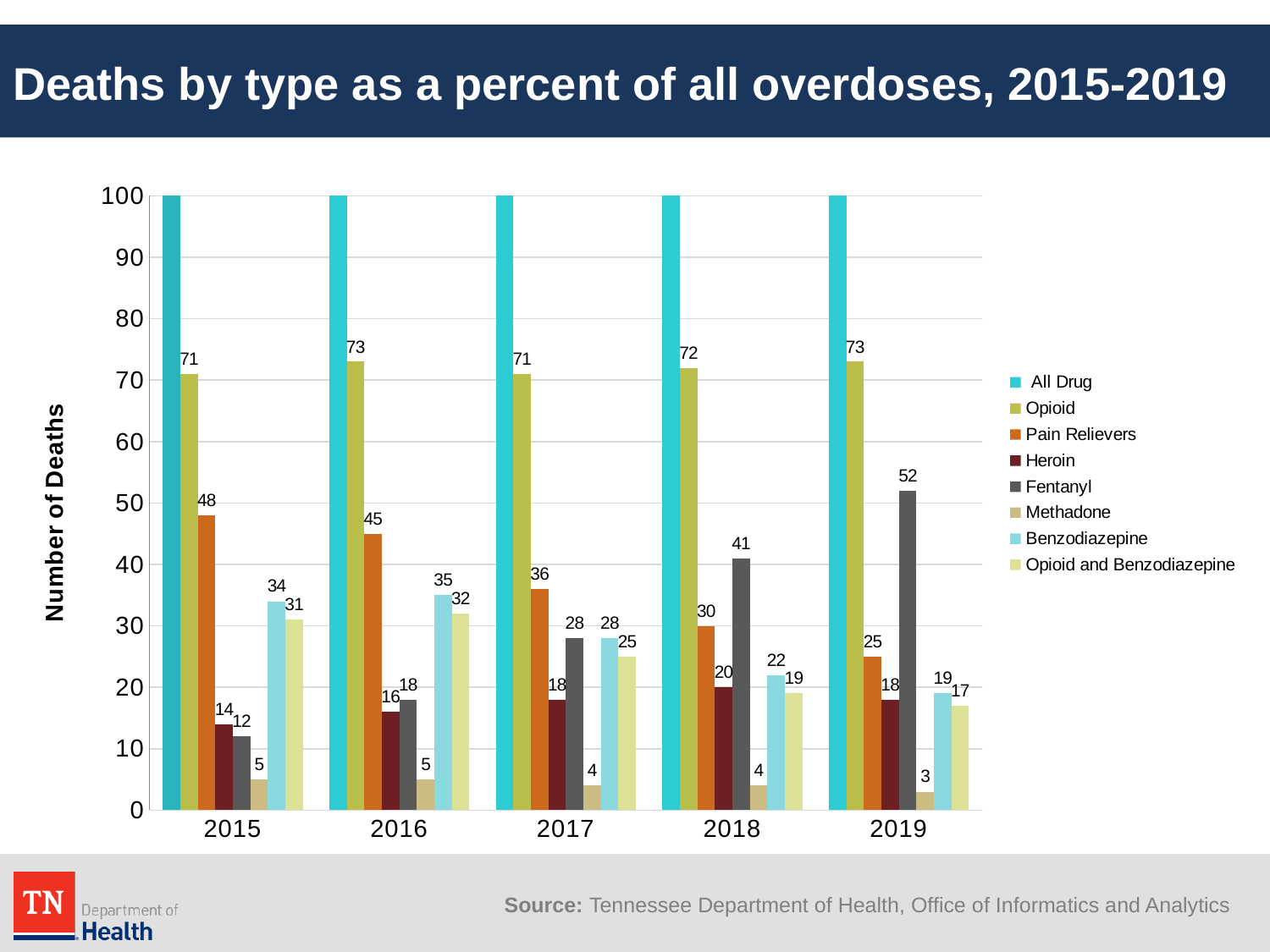
In which year is the Fentanyl value highest? 2019 What is the value for Pain Relievers in 2015? 48 Which is larger in 2018, Fentanyl or Pain Relievers? Fentanyl What is the value for Fentanyl in 2019? 52 Does the Pain Relievers value rise or fall from 2015 to 2019? fall What is the difference between the Fentanyl values in 2019 and 2015? 40 What kind of chart is shown on the slide? bar chart What is the label on the y axis? Number of Deaths How many years are shown on the x axis? 5 What is the value for Benzodiazepine in 2017? 28 In which year is the Pain Relievers value lowest? 2019 How many series does the legend list? 8